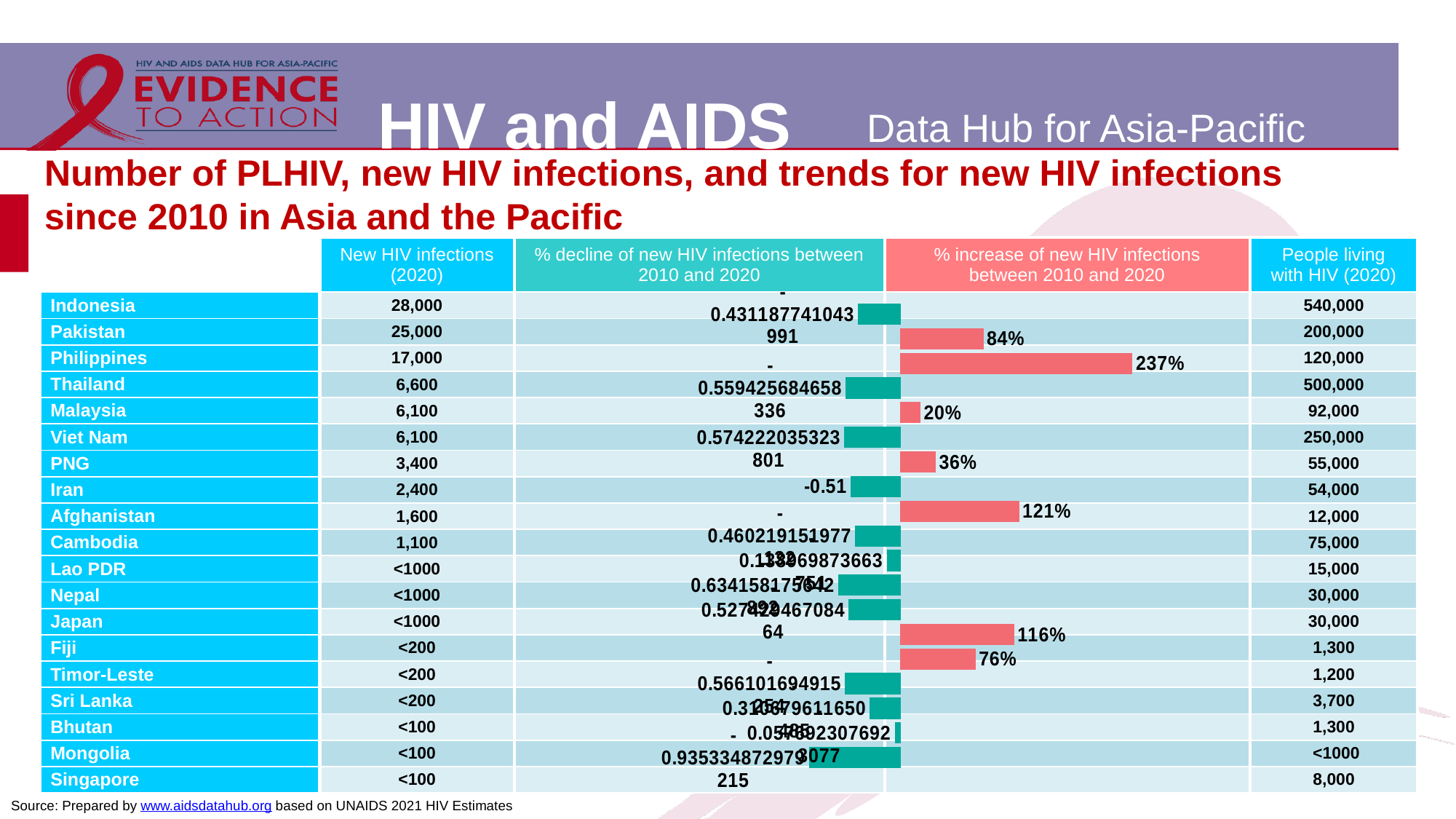
What is the % increase of new HIV infections between 2010 and 2020 shown for Timor-Leste? 76% What is the % increase of new HIV infections between 2010 and 2020 shown for PNG? 36% Which has a larger % increase of new HIV infections between 2010 and 2020, Afghanistan or Fiji? Afghanistan Among the countries with a red increase bar, which has the smallest % increase of new HIV infections? Malaysia What is the % increase of new HIV infections between 2010 and 2020 shown for Pakistan? 84% What is the % increase of new HIV infections between 2010 and 2020 shown for Afghanistan? 121% How many percentage points higher is the Philippines' % increase of new HIV infections than Pakistan's? 153 How many countries are shown with a red bar indicating a % increase of new HIV infections? 7 What is the % increase of new HIV infections between 2010 and 2020 shown for the Philippines? 237% What colour are the bars showing a % decline of new HIV infections between 2010 and 2020? Teal (green) What is the % increase of new HIV infections between 2010 and 2020 shown for Fiji? 116% Which country has the largest % increase of new HIV infections between 2010 and 2020? Philippines